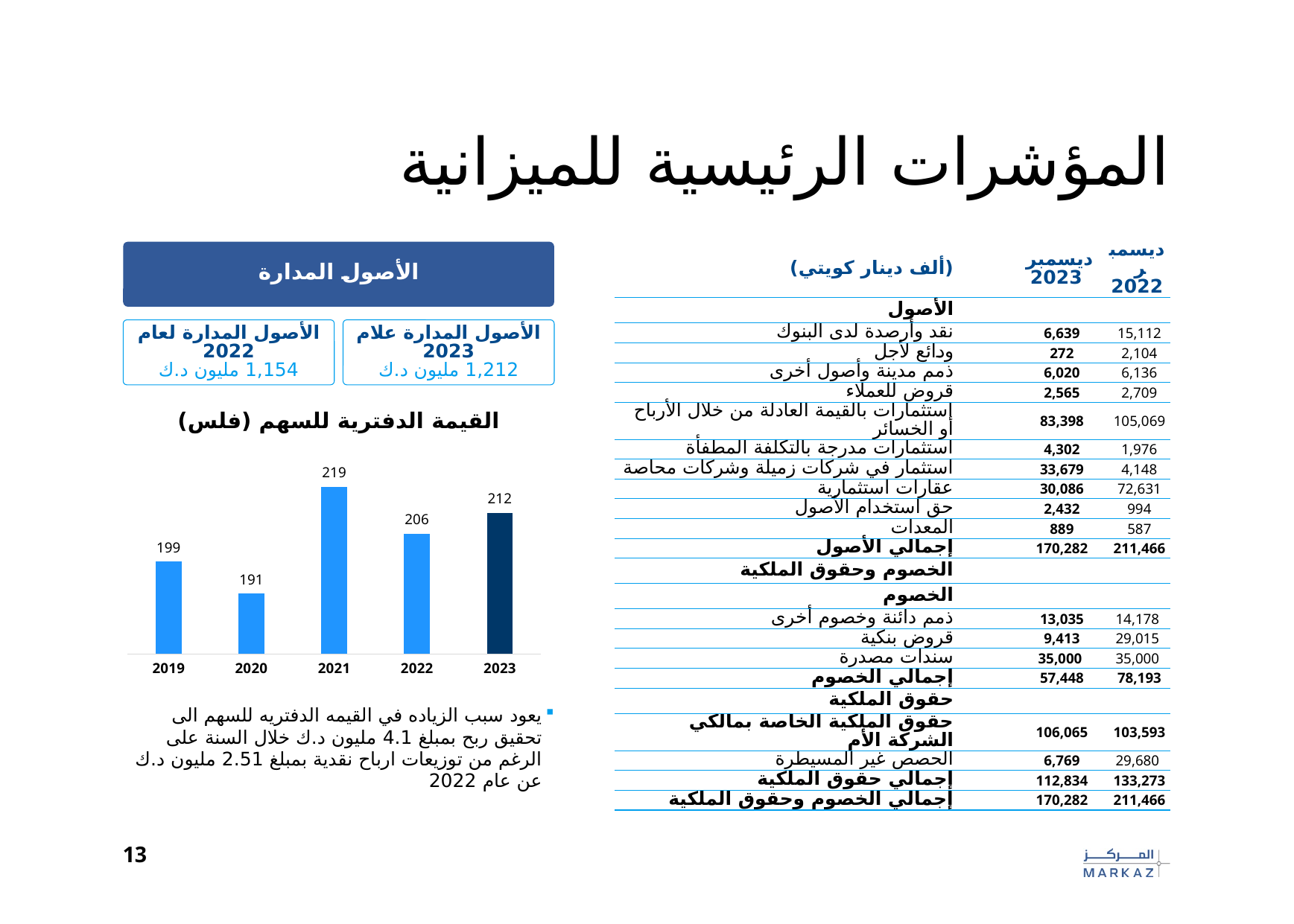
Which year has the highest book value per share in the chart? 2021 What value is shown for 2020 in the bar chart? 191 Which year has the lowest value in the book value per share chart? 2020 What is the value plotted for 2023 in the book value per share chart? 212 How many years are plotted in the book value per share chart? 5 What is the difference between the 2021 and 2020 values in the chart? 28 What is the title of the chart on the slide? القيمة الدفترية للسهم (فلس) What is the book value per share (القيمة الدفترية للسهم) shown for 2021? 219 Which is larger in the bar chart, the value for 2019 or the value for 2022? 2022 What value does the bar chart show for 2019? 199 What type of chart is used to show the book value per share? Bar chart By how much does the 2023 value exceed the 2022 value in the bar chart? 6